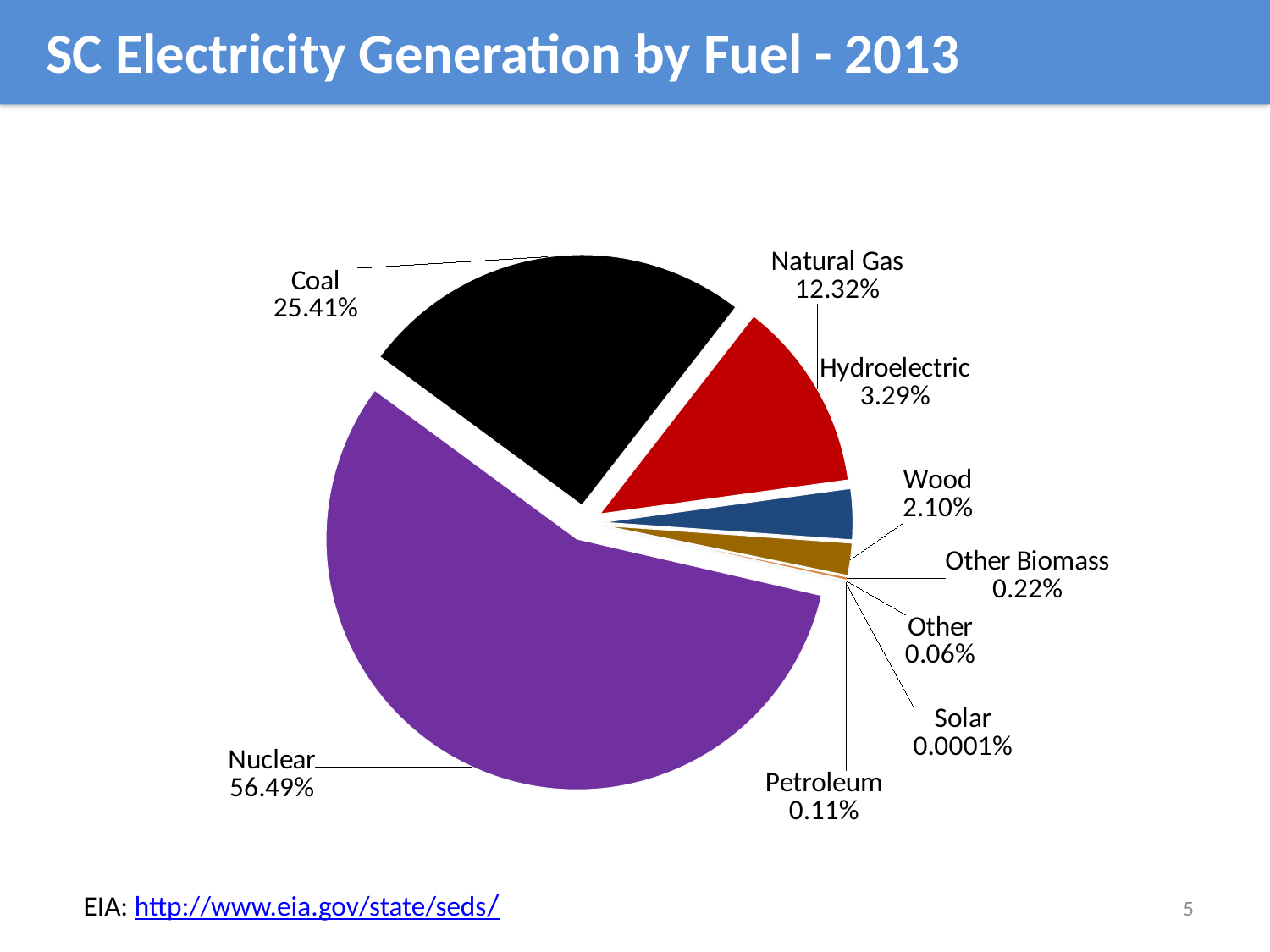
How many fuel categories are shown in the pie chart? 9 What colour is the Nuclear slice of the pie chart? purple What share of SC electricity generation in 2013 came from Nuclear? 56.49% What share of SC electricity generation in 2013 came from Natural Gas? 12.32% What share of SC electricity generation in 2013 came from Hydroelectric? 3.29% Which has a larger share, Wood or Hydroelectric? Hydroelectric What type of chart is shown on the slide? pie chart What is the difference in percentage points between the Nuclear and Coal shares? 31.08 What share of SC electricity generation in 2013 came from Solar? 0.0001% Which fuel has the largest share of SC electricity generation in 2013? Nuclear Which fuel has the smallest share of SC electricity generation in 2013? Solar What share of SC electricity generation in 2013 came from Coal? 25.41%